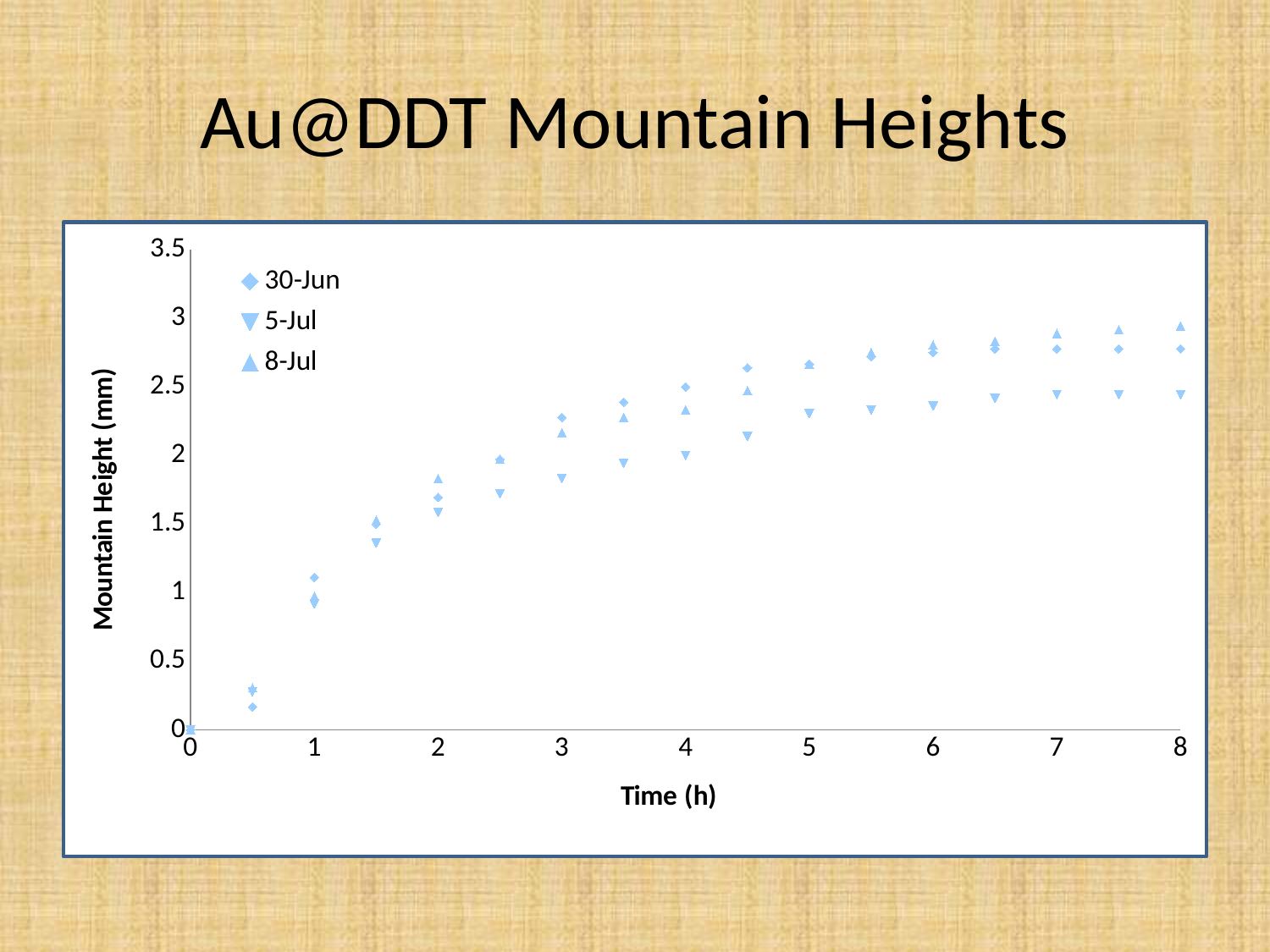
Is the value for 8-Jul at 2 h greater or less than 1.5? greater Is the value for 8-Jul at 8 h greater or less than 2.5? greater How many series does the legend list? 3 What is the label of the y axis? Mountain Height (mm) Which series has the lowest value at 8 h? 5-Jul What kind of chart is shown on the slide? Scatter chart Do the mountain heights rise or fall as time increases? Rise Which series are listed in the legend? 30-Jun, 5-Jul, 8-Jul At 8 h, which series has the higher value, 8-Jul or 5-Jul? 8-Jul Is the value for 5-Jul at 3 h greater or less than 2? less At 3 h, which series has the higher value, 30-Jun or 5-Jul? 30-Jun